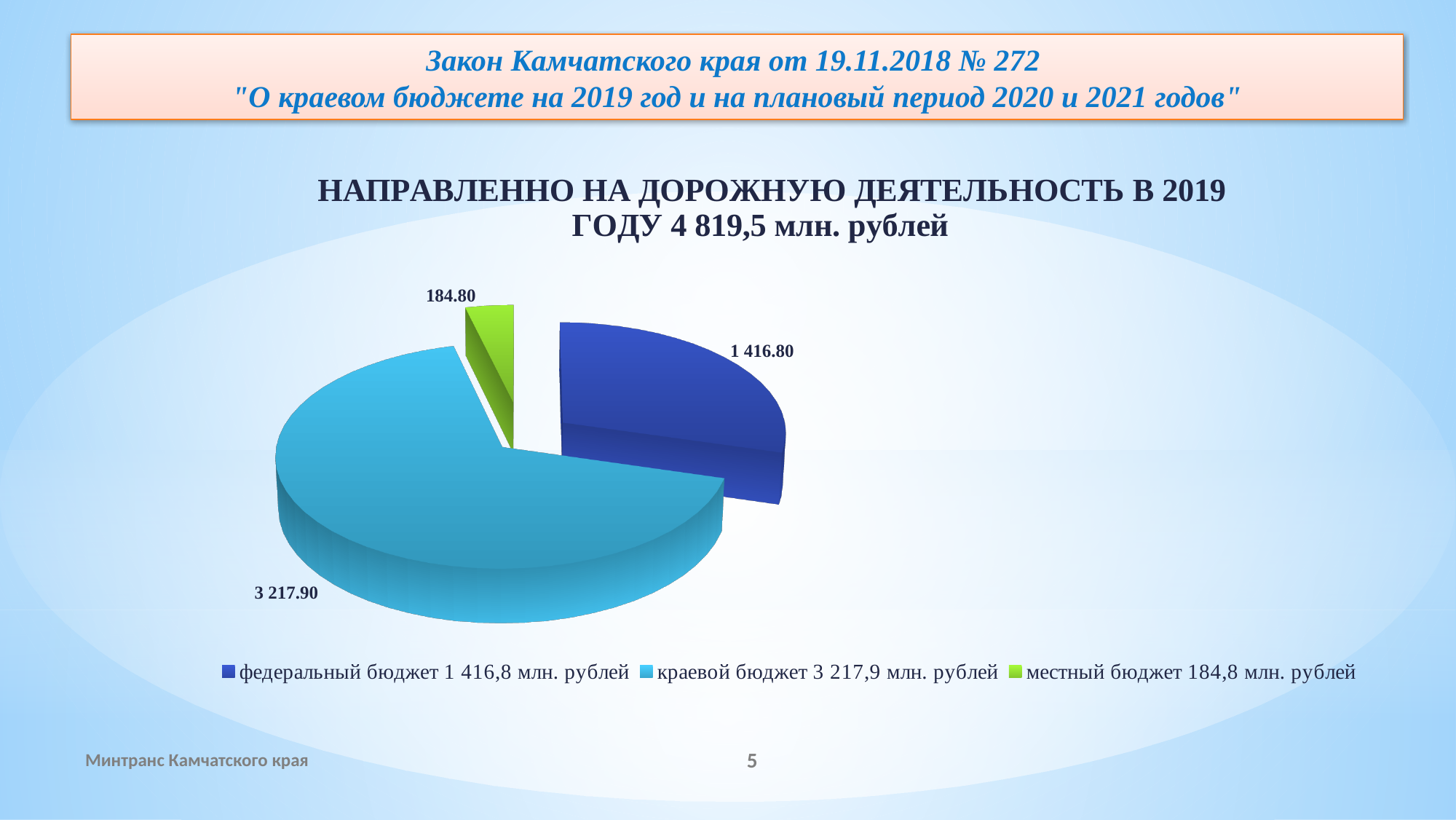
How many slices does the pie chart have? 3 What is the difference between the федеральный бюджет and местный бюджет values? 1 232.00 What is the value shown for федеральный бюджет? 1 416.80 What total amount directed to road activity in 2019 is stated in the chart title? 4 819,5 млн. рублей Which is larger, федеральный бюджет or местный бюджет? федеральный бюджет What colour is the slice for местный бюджет? green Which budget source has the largest slice of the pie? краевой бюджет What is the value shown for местный бюджет? 184.80 What is the value shown for краевой бюджет? 3 217.90 What is the difference between the краевой бюджет and федеральный бюджет values? 1 801.10 What type of chart is shown on the slide? pie chart Which budget source has the smallest slice of the pie? местный бюджет